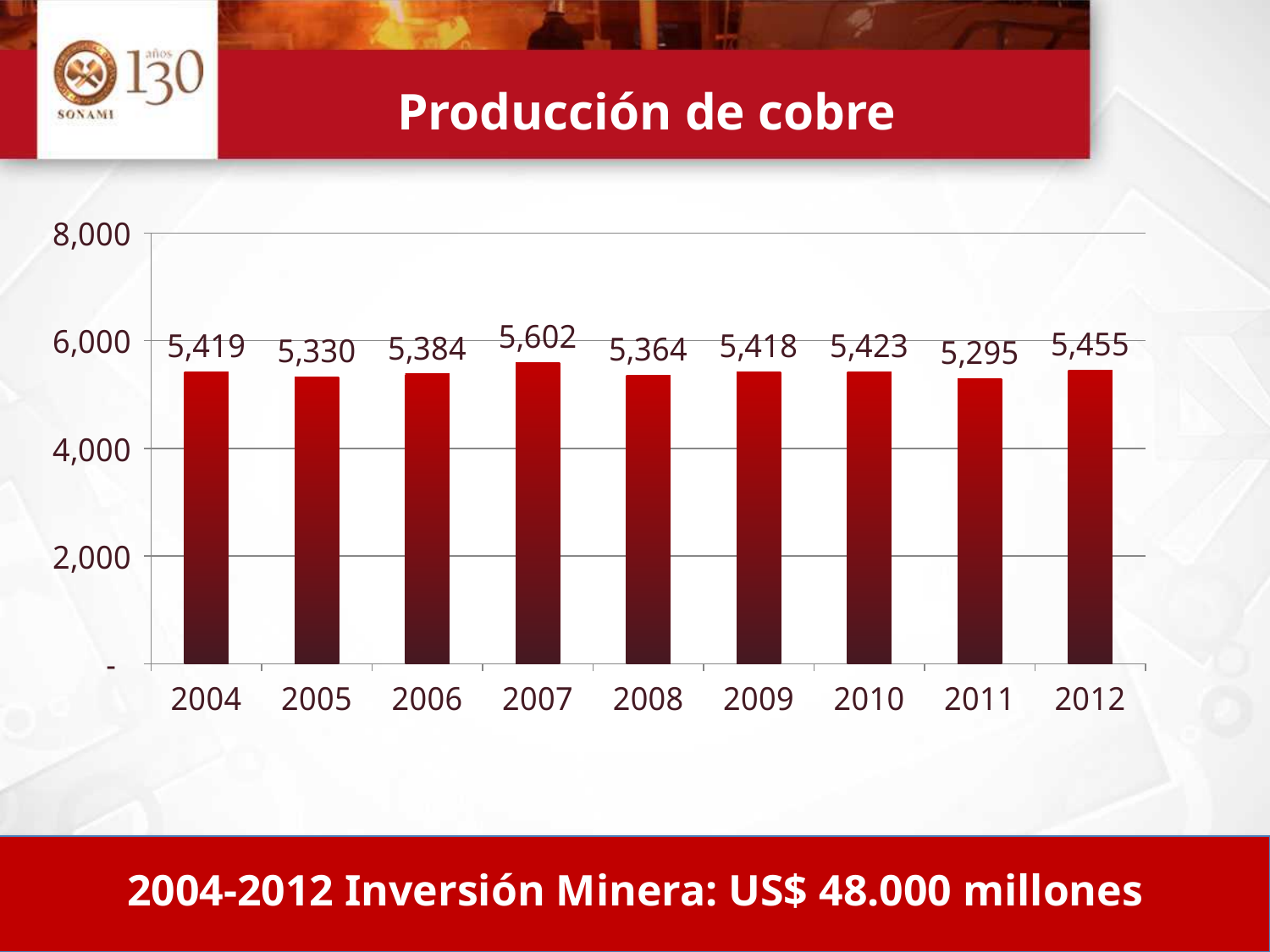
Which year has a larger copper production value, 2006 or 2012? 2012 How many years are shown on the x axis of the chart? 9 What is the copper production value shown for 2007? 5,602 What is the title of the chart on the slide? Producción de cobre What is the difference between the 2012 and 2005 copper production values? 125 What is the copper production value shown for 2011? 5,295 What is the copper production value shown for 2004? 5,419 Which year has the highest copper production? 2007 What type of chart is used to show copper production? bar chart What is the difference between the 2007 and 2011 copper production values? 307 Is the copper production value for 2009 greater or less than 6,000? less Which year has the lowest copper production? 2011